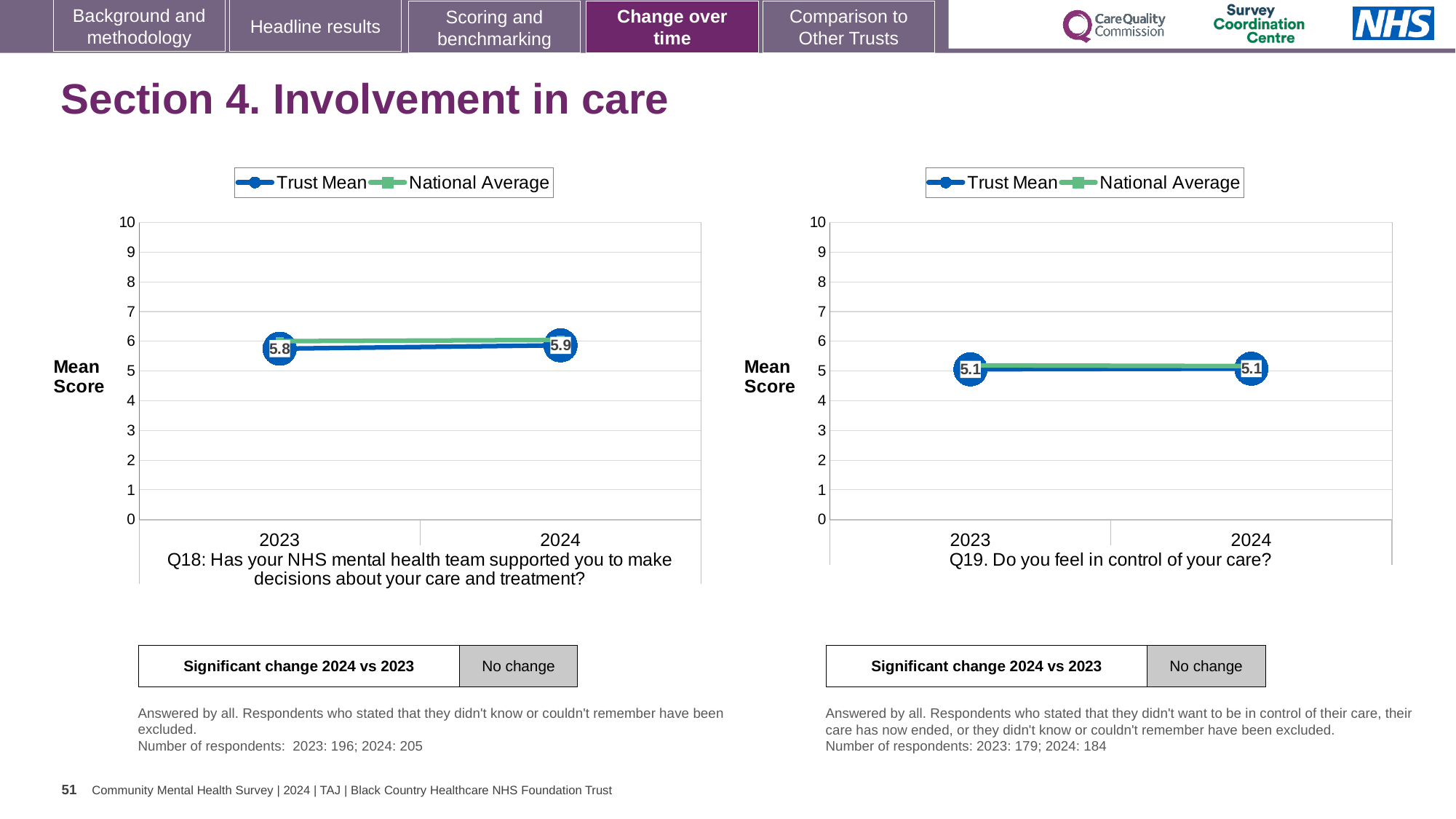
In the Q18 chart, is the National Average value for 2024 greater or less than 4? greater How many series does the legend of the Q19 chart list? 2 What kind of chart is the Q19 chart? Line chart What are the two series named in the legend of the Q18 chart? Trust Mean and National Average In the Q19 chart, what is the Trust Mean score for 2024? 5.1 How many years are plotted on the x axis of the Q18 chart? 2 In the Q18 chart, what is the difference between the Trust Mean scores for 2024 and 2023? 0.1 In the Q18 chart, what is the Trust Mean score for 2024? 5.9 In the Q18 chart, what is the Trust Mean score for 2023? 5.8 In the Q19 chart, does the Trust Mean rise, fall or stay the same from 2023 to 2024? Stays the same In the Q18 chart, does the Trust Mean rise or fall from 2023 to 2024? Rise In the Q19 chart, is the National Average value for 2023 greater or less than 7? less